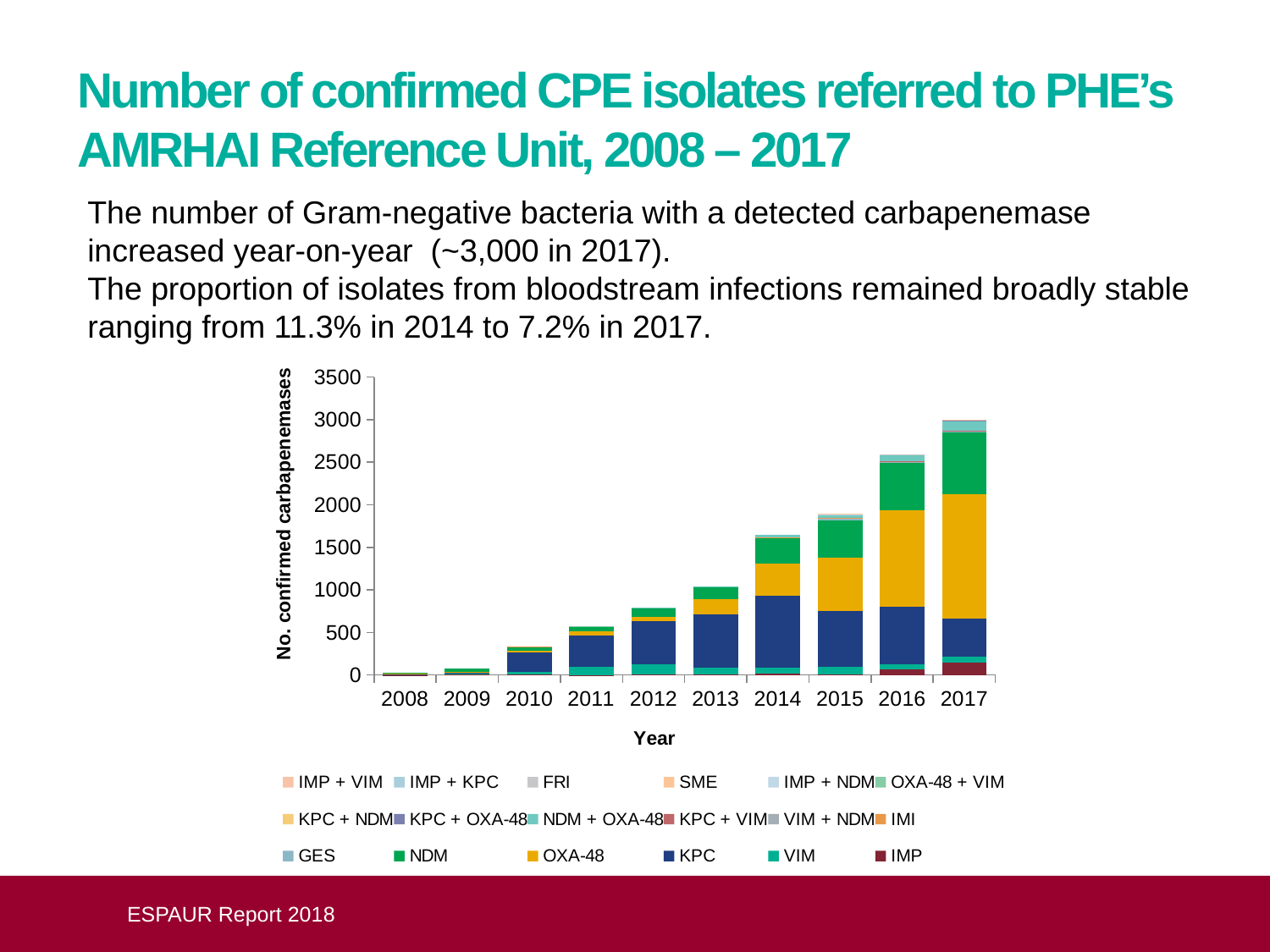
Is the total value for 2012 greater or less than 1000? less How many years are shown on the x axis of the chart? 10 Is the total value for 2016 greater or less than 2000? greater How many series does the chart's legend list? 18 Is the total value for 2010 greater or less than 500? less Which year has a larger total, 2014 or 2015? 2015 Do the total numbers of confirmed carbapenemases rise or fall from 2008 to 2017? Rise What is the label on the y axis of the chart? No. confirmed carbapenemases Which year has the highest total number of confirmed carbapenemases? 2017 What kind of chart is shown on the slide? Stacked bar chart Which year has the lowest total number of confirmed carbapenemases? 2008